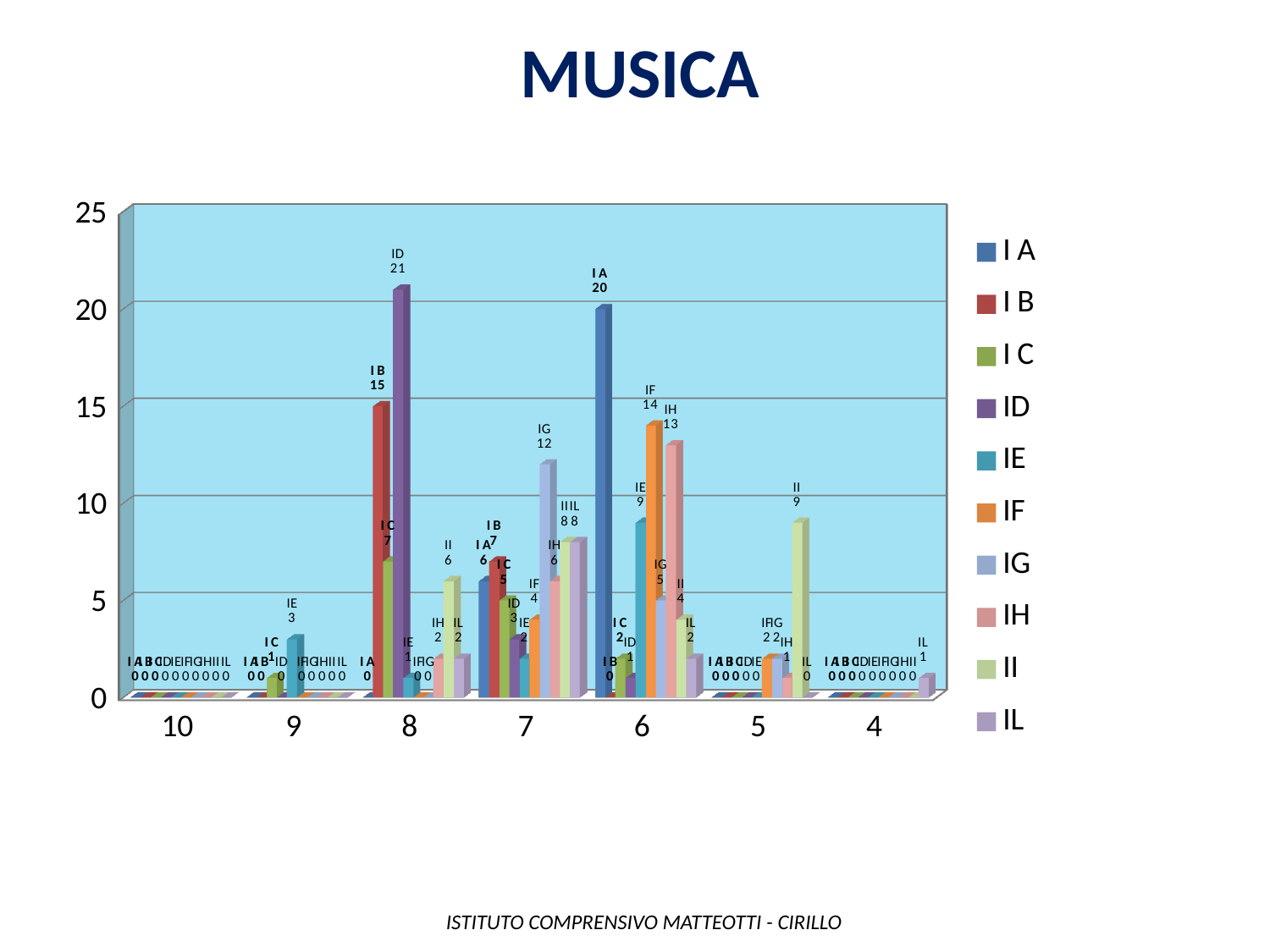
What kind of chart is shown on the slide? bar chart Which series has the highest value at grade 6? I A Is the value for I A at grade 6 greater or less than 15? greater Which series has the highest value at grade 8? ID How many series does the legend list? 10 What is the value for ID at grade 8? 21 What is the difference between I B and I C at grade 8? 8 How many grade categories are shown on the x axis? 7 At grade 6, which is larger, IF or IH? IF What is the value for IG at grade 7? 12 What is the value for II at grade 5? 9 What is the value for I A at grade 6? 20